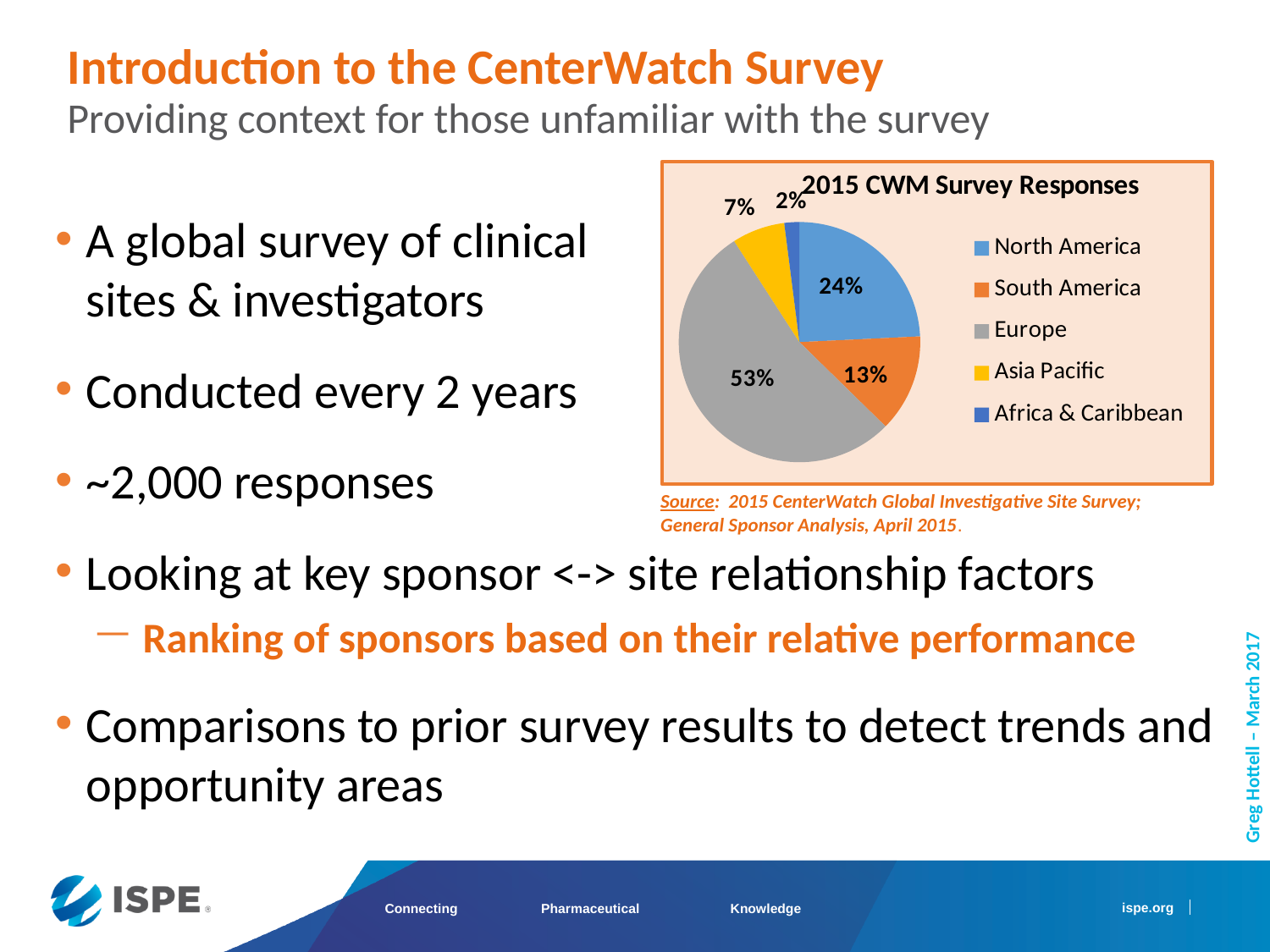
How many regions are shown in the pie chart? 5 Which region has the smallest share of the 2015 CWM Survey Responses? Africa & Caribbean What share of the 2015 CWM Survey Responses came from Europe? 53% What share of the 2015 CWM Survey Responses came from North America? 24% What share of the 2015 CWM Survey Responses came from South America? 13% What type of chart is shown on the slide? pie chart Which region has the largest share of the 2015 CWM Survey Responses? Europe What share of the 2015 CWM Survey Responses came from Asia Pacific? 7% What is the title of the chart? 2015 CWM Survey Responses What share of the 2015 CWM Survey Responses came from Africa & Caribbean? 2% What is the difference in percentage points between Europe's share and North America's share? 29 Which has a larger share of responses, South America or Asia Pacific? South America